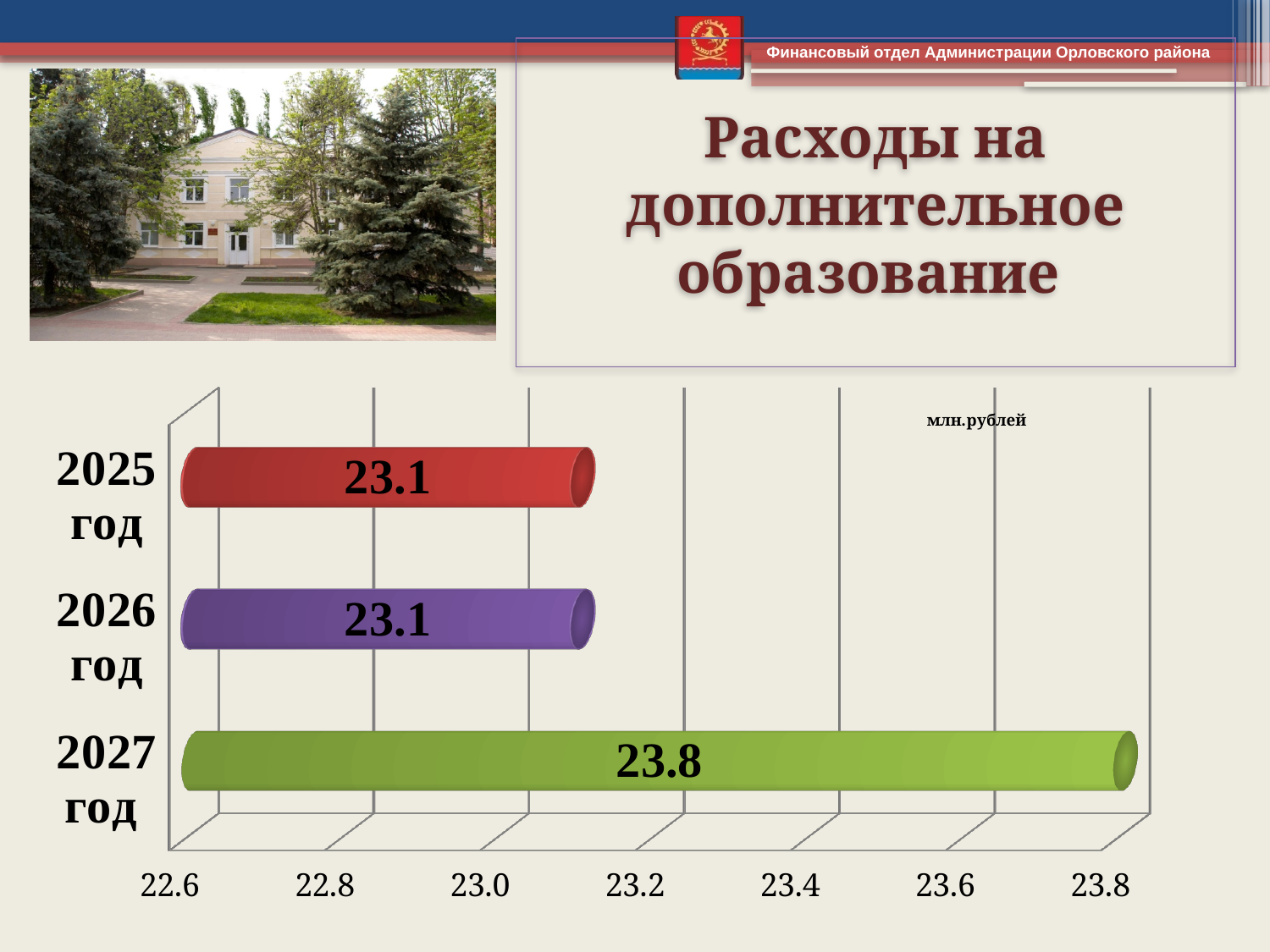
Is the value for 2027 год greater or less than 23.4? greater What unit is indicated on the chart? млн.рублей How many categories are shown in the chart? 3 What kind of chart is shown on the slide? bar chart What is the difference between the values for 2027 год and 2025 год? 0.7 Which is larger, the value for 2027 год or the value for 2026 год? 2027 год What is the title of the slide? Расходы на дополнительное образование Is the value for 2025 год greater or less than 23.4? less What is the value for 2026 год? 23.1 Which year has the highest value? 2027 год What is the value for 2027 год? 23.8 What is the value for 2025 год? 23.1